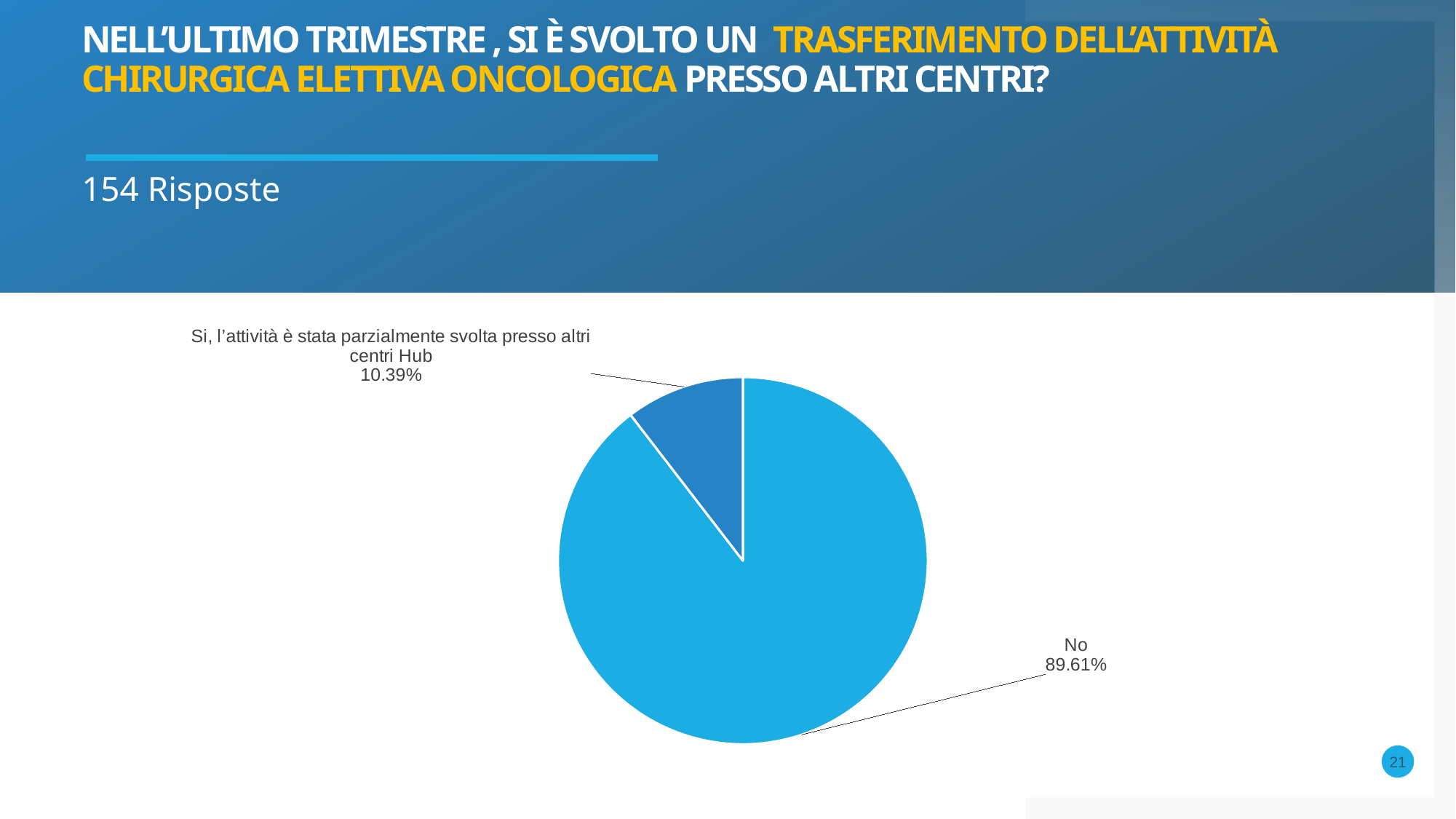
What colour is the "No" slice of the pie? Light blue Which slice of the pie is the largest? No What kind of chart is shown on the slide? Pie chart Which slice of the pie is the smallest? Si, l'attività è stata parzialmente svolta presso altri centri Hub What share of responses is "Si, l'attività è stata parzialmente svolta presso altri centri Hub"? 10.39% Which is larger, the "No" slice or the "Si, l'attività è stata parzialmente svolta presso altri centri Hub" slice? No What share of responses is "No"? 89.61% Is the share for "No" greater or less than 50%? greater What is the difference in percentage points between the "No" slice and the "Si, l'attività è stata parzialmente svolta presso altri centri Hub" slice? 79.22 percentage points How many responses does the slide say the chart is based on? 154 Risposte How many slices does the pie chart have? 2